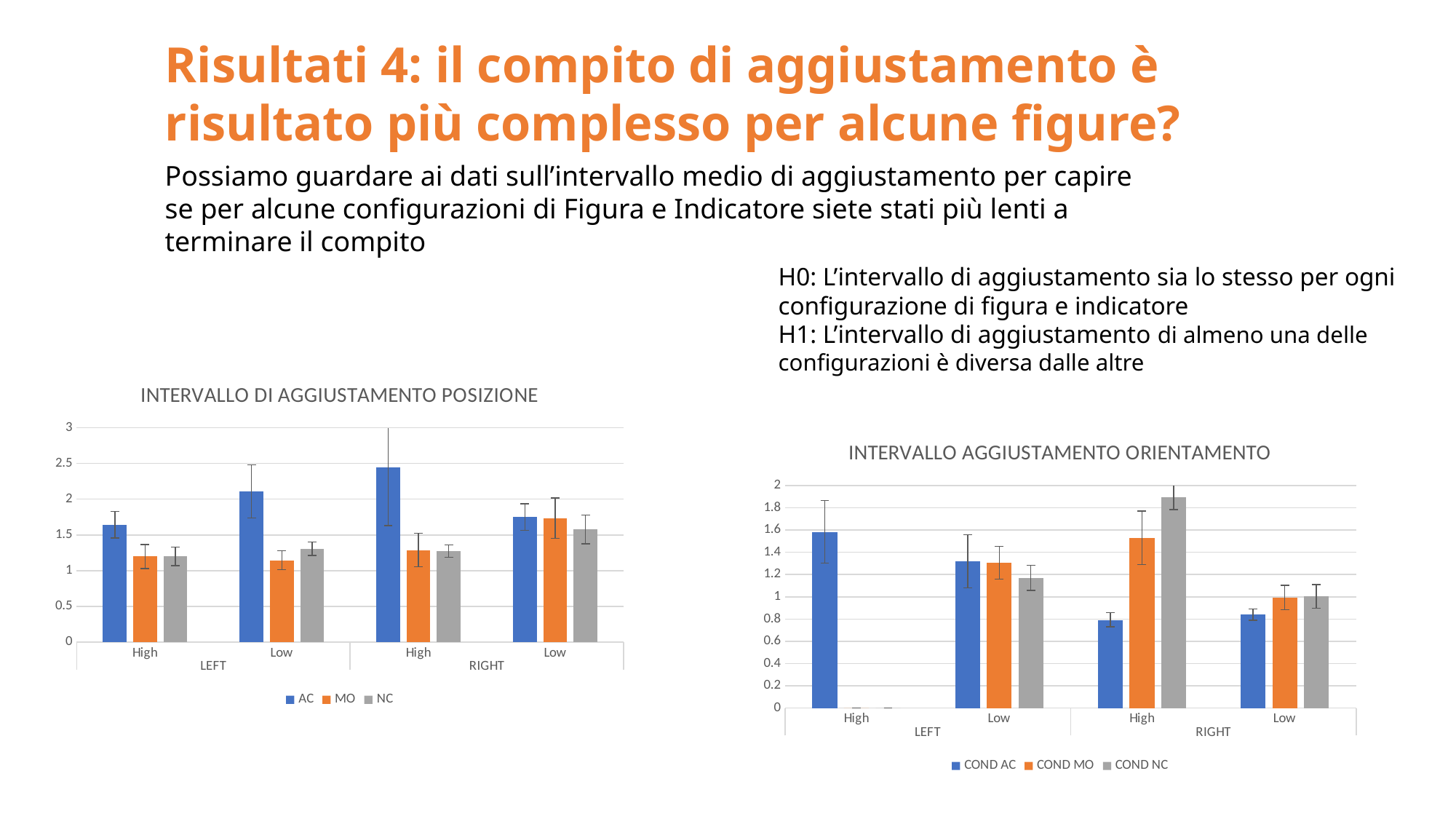
In the "INTERVALLO DI AGGIUSTAMENTO POSIZIONE" chart, for LEFT High, which is larger: AC or MO? AC How many series does the legend of the "INTERVALLO DI AGGIUSTAMENTO POSIZIONE" chart list? 3 In the "INTERVALLO DI AGGIUSTAMENTO POSIZIONE" chart, how many category groups are shown on the x axis? 4 In the "INTERVALLO AGGIUSTAMENTO ORIENTAMENTO" chart, is the COND AC value for RIGHT High greater or less than 1? less In the "INTERVALLO DI AGGIUSTAMENTO POSIZIONE" chart, is the AC value for RIGHT High greater or less than 2? greater In the "INTERVALLO DI AGGIUSTAMENTO POSIZIONE" chart, is the MO value for LEFT Low greater or less than 1.5? less In the "INTERVALLO DI AGGIUSTAMENTO POSIZIONE" chart, for which category is the AC bar highest? RIGHT High What kind of chart is the "INTERVALLO DI AGGIUSTAMENTO POSIZIONE" chart? bar chart In the "INTERVALLO AGGIUSTAMENTO ORIENTAMENTO" chart, for which category is the COND NC bar highest? RIGHT High In the "INTERVALLO AGGIUSTAMENTO ORIENTAMENTO" chart, for RIGHT High, which is larger: COND AC or COND NC? COND NC What are the legend entries of the "INTERVALLO AGGIUSTAMENTO ORIENTAMENTO" chart? COND AC, COND MO, COND NC